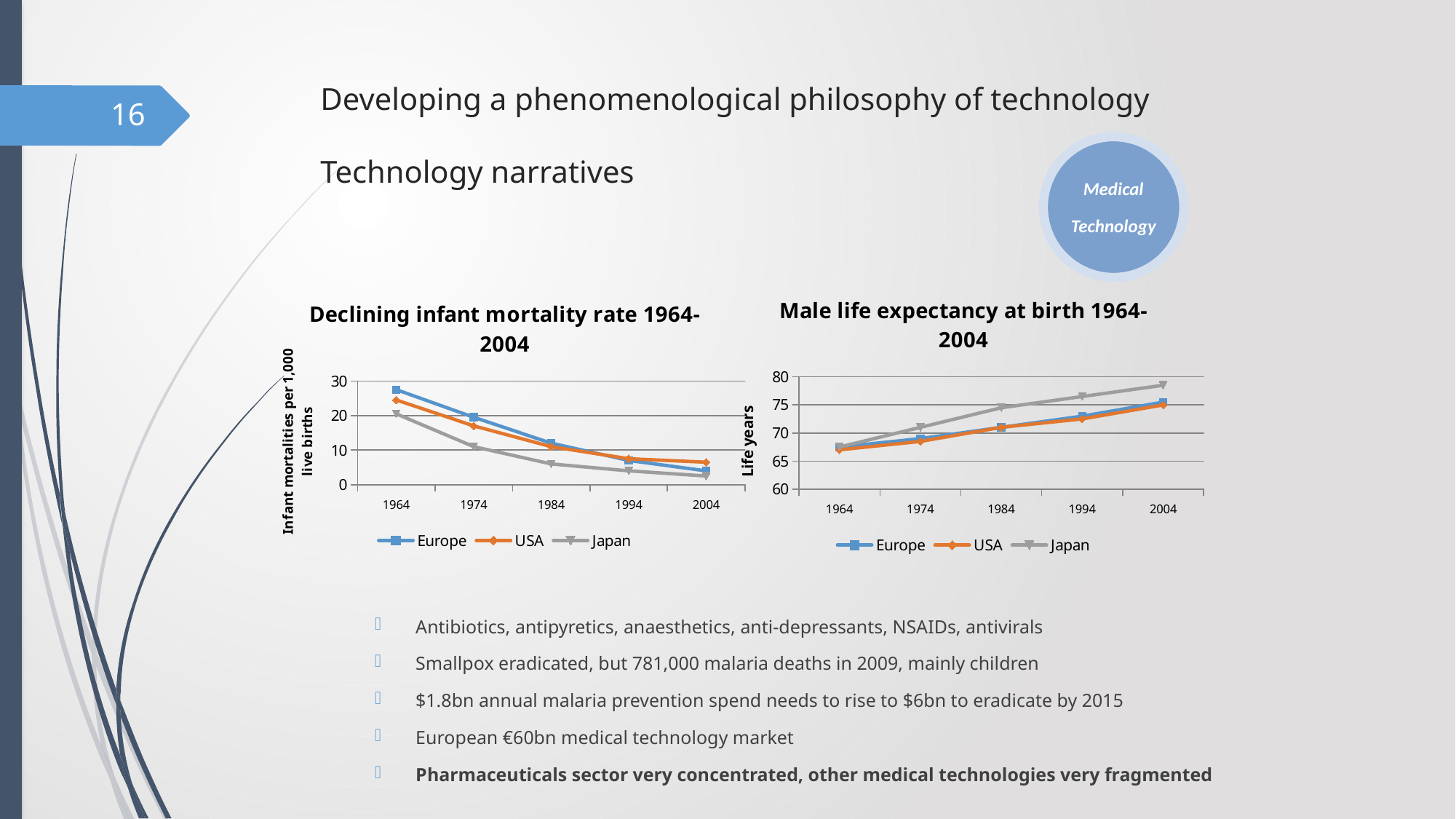
In the "Declining infant mortality rate 1964-2004" chart, which series has the highest value in 1964? Europe In the "Declining infant mortality rate 1964-2004" chart, does the Europe line rise or fall from 1964 to 2004? fall How many years are shown on the x axis of the "Declining infant mortality rate 1964-2004" chart? 5 What is the y-axis title of the "Male life expectancy at birth 1964-2004" chart? Life years What kind of chart is the "Declining infant mortality rate 1964-2004" chart? line chart In the "Declining infant mortality rate 1964-2004" chart, is the value for Europe in 1964 greater or less than 20? greater In the "Declining infant mortality rate 1964-2004" chart, which series has the lowest value in 2004? Japan In the "Male life expectancy at birth 1964-2004" chart, is the value for Japan in 2004 greater or less than 75? greater In the "Male life expectancy at birth 1964-2004" chart, does the Japan line rise or fall from 1964 to 2004? rise How many series does the legend of the "Declining infant mortality rate 1964-2004" chart list? 3 In the "Declining infant mortality rate 1964-2004" chart, is the value for Japan in 1984 greater or less than 10? less In the "Male life expectancy at birth 1964-2004" chart, which is larger in 1984, Japan or USA? Japan